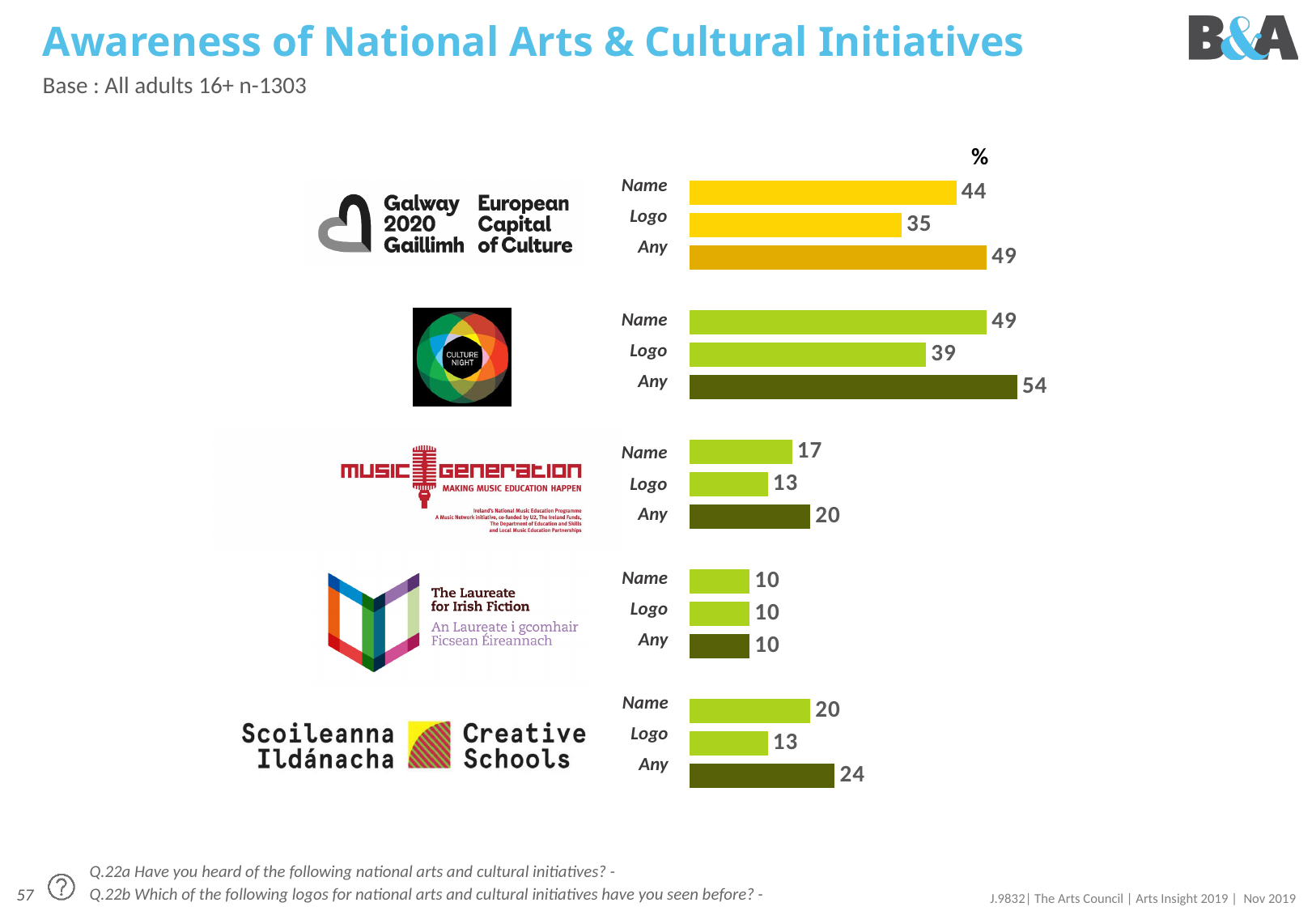
What is the 'Logo' awareness value for Creative Schools? 13 What is the 'Logo' awareness value for The Laureate for Irish Fiction? 10 What is the base described on the slide? All adults 16+ n-1303 What is the difference between the 'Name' and 'Logo' awareness values for Galway 2020? 9 Which initiative has the highest 'Any' awareness value? Culture Night How many initiatives are shown in the chart? 5 What is the 'Any' awareness value for Culture Night? 54 What kind of chart is used on this slide? Bar chart What is the difference between the 'Any' values for Culture Night and Galway 2020? 5 Which is larger: the 'Any' value for Music Generation or the 'Any' value for Creative Schools? Creative Schools Which initiative has the lowest 'Name' awareness value? The Laureate for Irish Fiction What is the 'Name' awareness value for Galway 2020 European Capital of Culture? 44